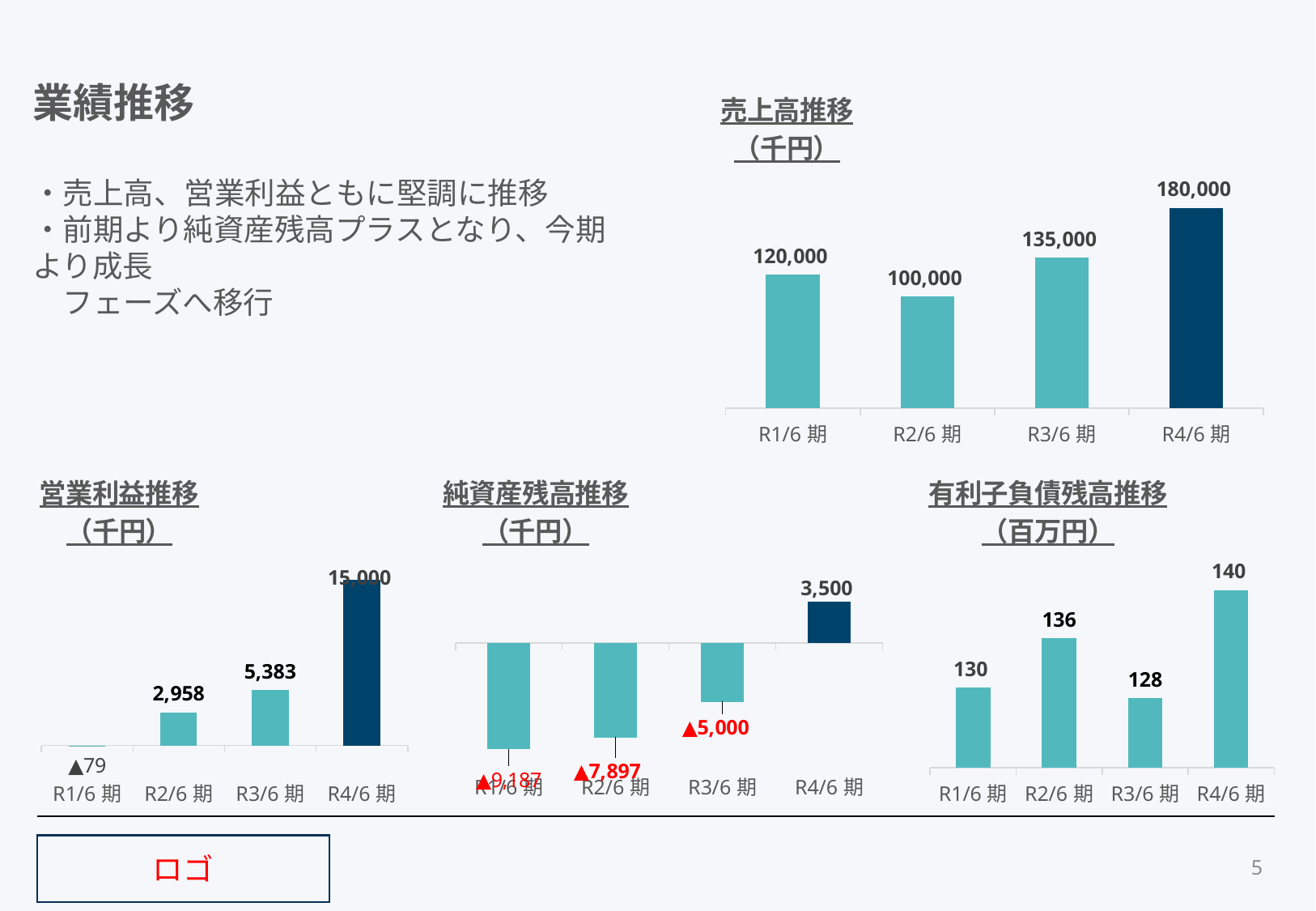
In the 有利子負債残高推移 chart, which is larger, R1/6 期 or R3/6 期? R1/6 期 What type of chart is the 売上高推移 chart? Bar chart In the 営業利益推移 chart, what is the value for R3/6 期? 5,383 How many periods are shown in the 有利子負債残高推移 chart? 4 In the 有利子負債残高推移 chart, what is the value for R2/6 期? 136 In the 売上高推移 chart, what is the difference between R4/6 期 and R3/6 期? 45,000 In the 純資産残高推移 chart, what is the value for R3/6 期? ▲5,000 In the 営業利益推移 chart, which period has the highest value? R4/6 期 In the 純資産残高推移 chart, which period is the only one with a positive value? R4/6 期 In the 営業利益推移 chart, what is the value for R1/6 期? ▲79 In the 売上高推移 chart, what is the value for R4/6 期? 180,000 In the 売上高推移 chart, which period has the lowest value? R2/6 期